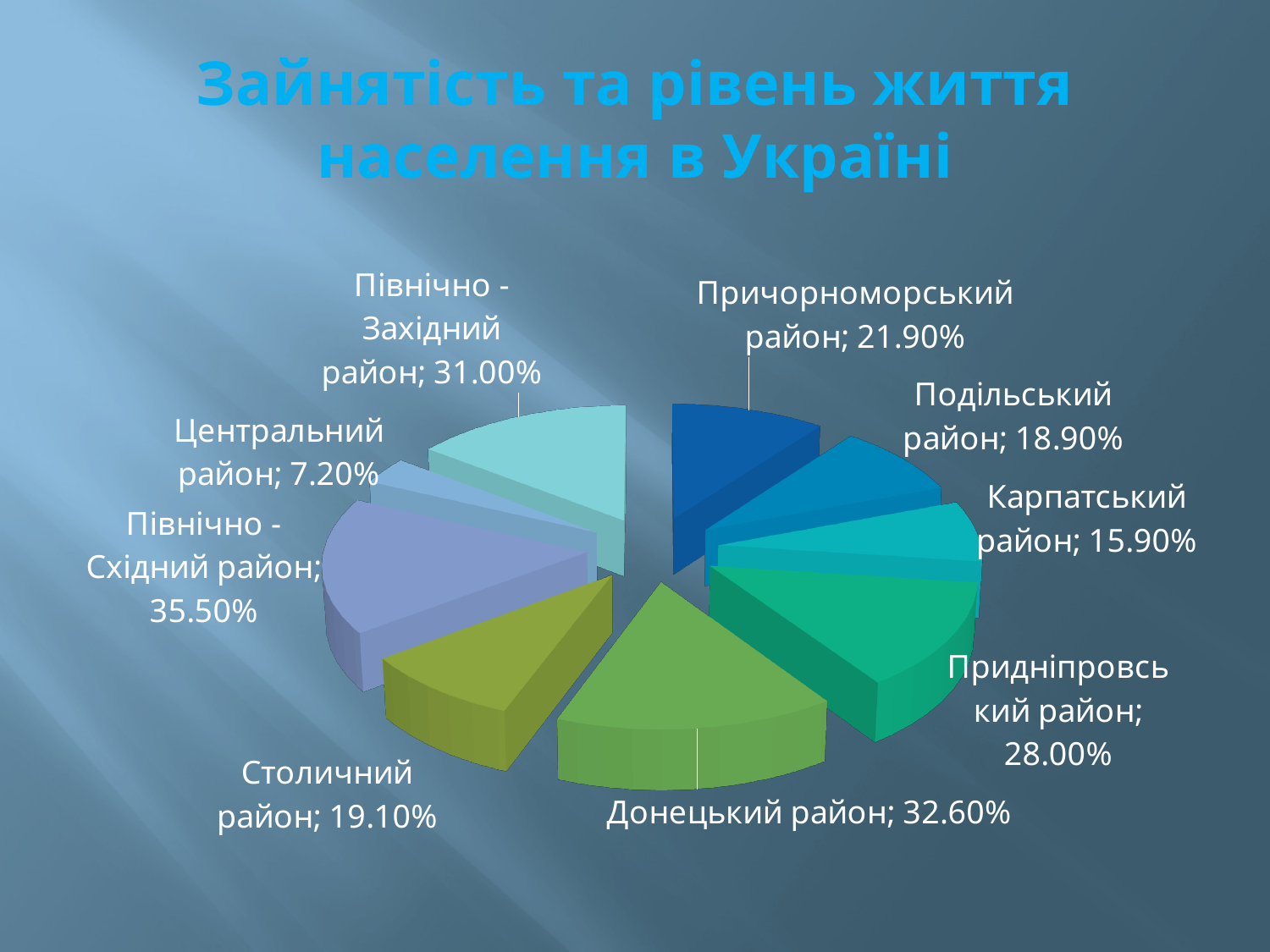
What is the difference between the values for Причорноморський район and Подільський район? 3.00% Which region has the smallest value in the chart? Центральний район What value is shown for Карпатський район? 15.90% What value is shown for Донецький район? 32.60% What value is shown for Столичний район? 19.10% What value is shown for Придніпровський район? 28.00% Which is larger, the value for Донецький район or the value for Північно-Західний район? Донецький район How many regions are shown in the chart? 9 What kind of chart is shown on the slide? Pie chart What is the title of the slide? Зайнятість та рівень життя населення в Україні Which region has the largest value in the chart? Північно-Східний район What is the difference between the values for Північно-Західний район and Центральний район? 23.80%